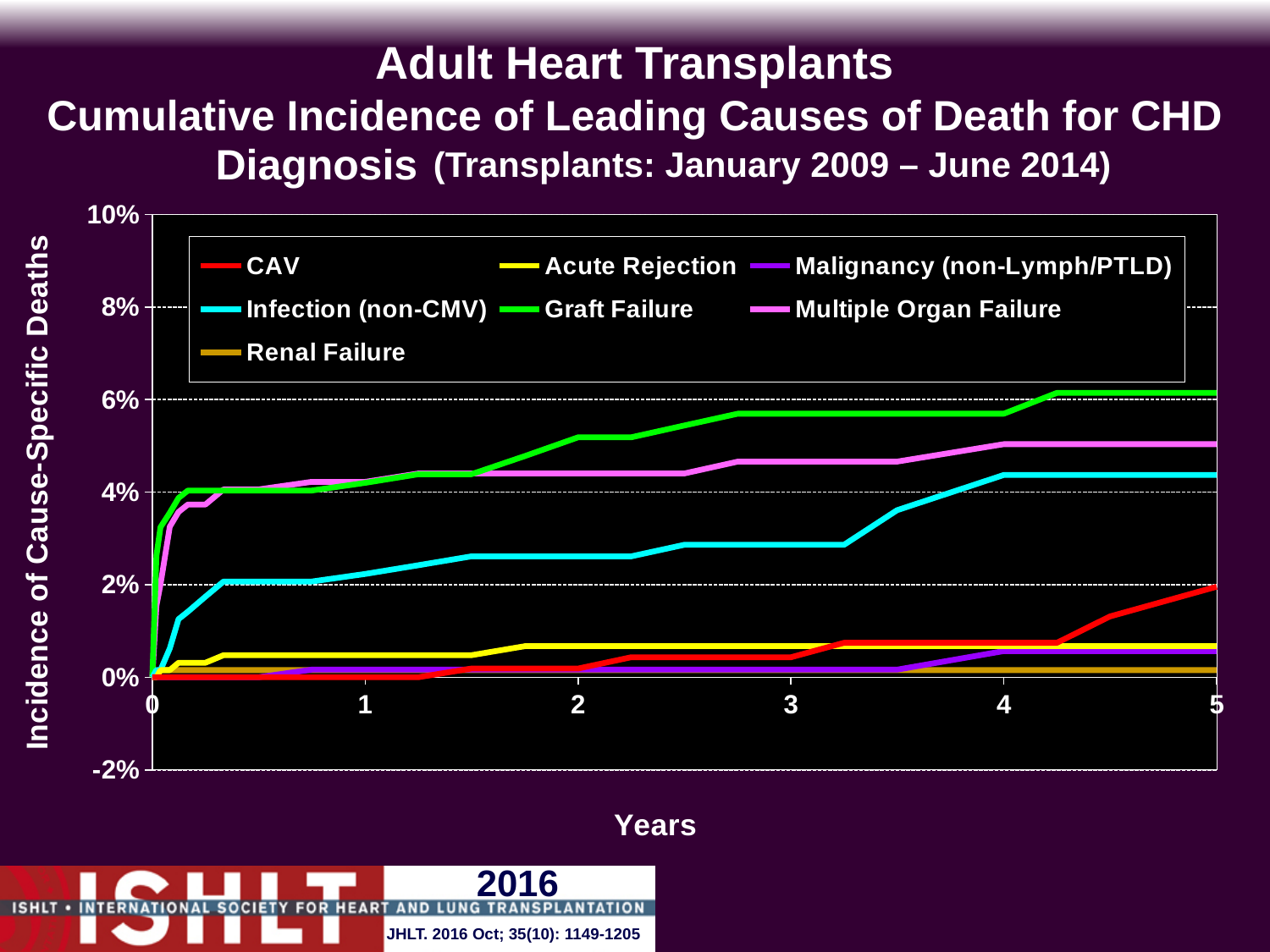
What transplant period is given in the chart title? January 2009 – June 2014 Is the cumulative incidence for Multiple Organ Failure at 5 years greater or less than 4%? greater Is the cumulative incidence for Graft Failure at 5 years greater or less than 6%? greater At 5 years, which has the higher cumulative incidence: Infection (non-CMV) or Multiple Organ Failure? Multiple Organ Failure At 5 years, which has the higher cumulative incidence: CAV or Acute Rejection? CAV Does the cumulative incidence for Graft Failure rise or fall over the years shown? rise Is the cumulative incidence for Infection (non-CMV) at 5 years greater or less than 4%? greater Which cause of death has the lowest cumulative incidence at 5 years? Renal Failure What kind of chart is shown on the slide? line chart Which cause of death has the highest cumulative incidence at 5 years? Graft Failure How many series does the legend list? 7